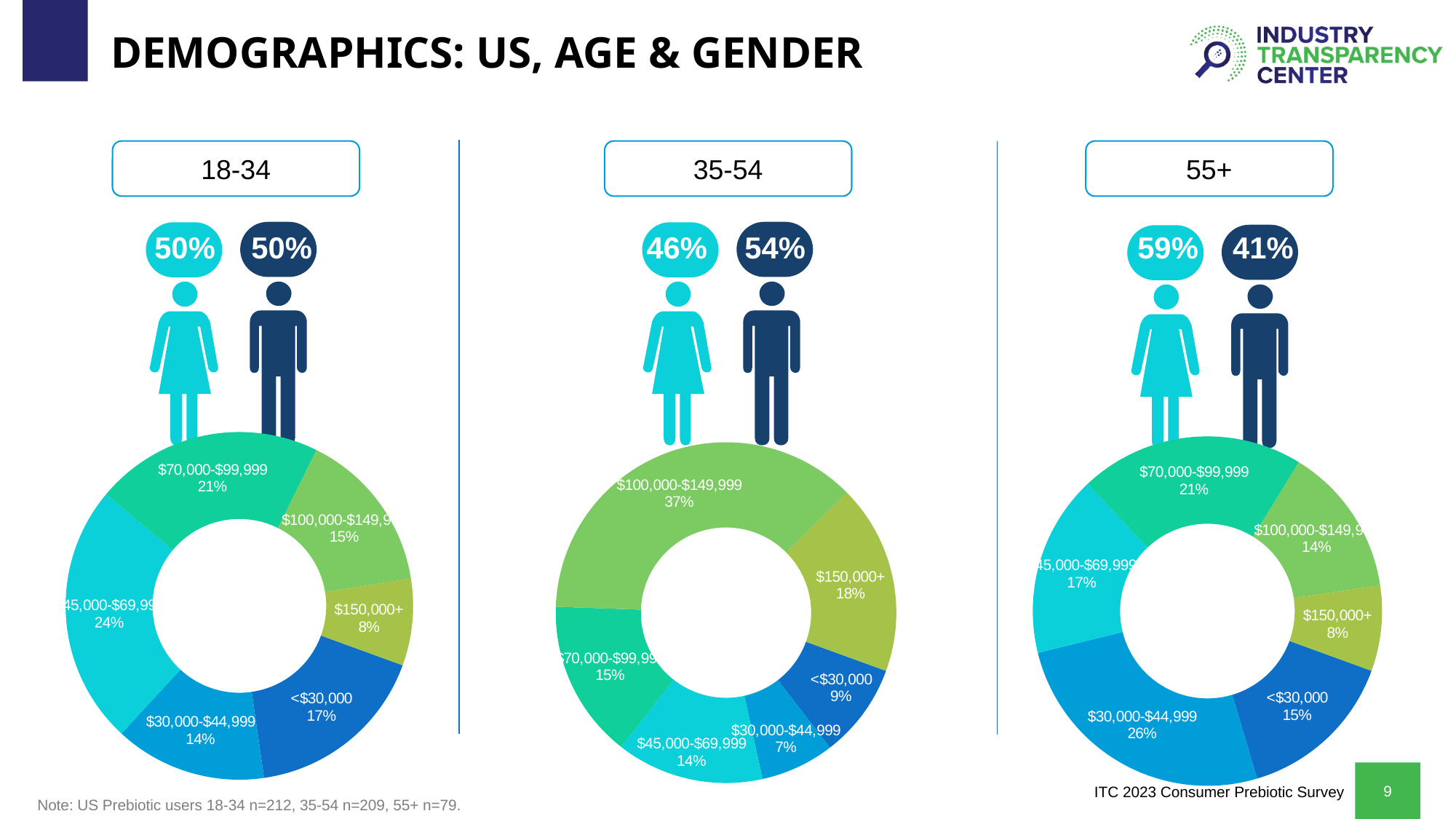
In the 35-54 donut chart, which income bracket has the largest share? $100,000-$149,999 In the 35-54 donut chart, which income bracket has the smallest share? $30,000-$44,999 In the 55+ donut chart, which income bracket has the smallest share? $150,000+ In the 35-54 donut chart, what share of respondents earn $100,000-$149,999? 37% In the 55+ donut chart, which is larger: the share for <$30,000 or the share for $45,000-$69,999? $45,000-$69,999 In the 55+ age group, what percentage of respondents are female? 59% In the 55+ donut chart, what share of respondents earn $30,000-$44,999? 26% In the 35-54 age group, what percentage of respondents are male? 54% In the 18-34 donut chart, what share of respondents earn $45,000-$69,999? 24% In the 18-34 donut chart, what is the difference in percentage points between the $45,000-$69,999 share and the $150,000+ share? 16 What type of chart is used to show income distribution for each age group? Donut (pie) chart How many income brackets are shown in the 35-54 donut chart? 6